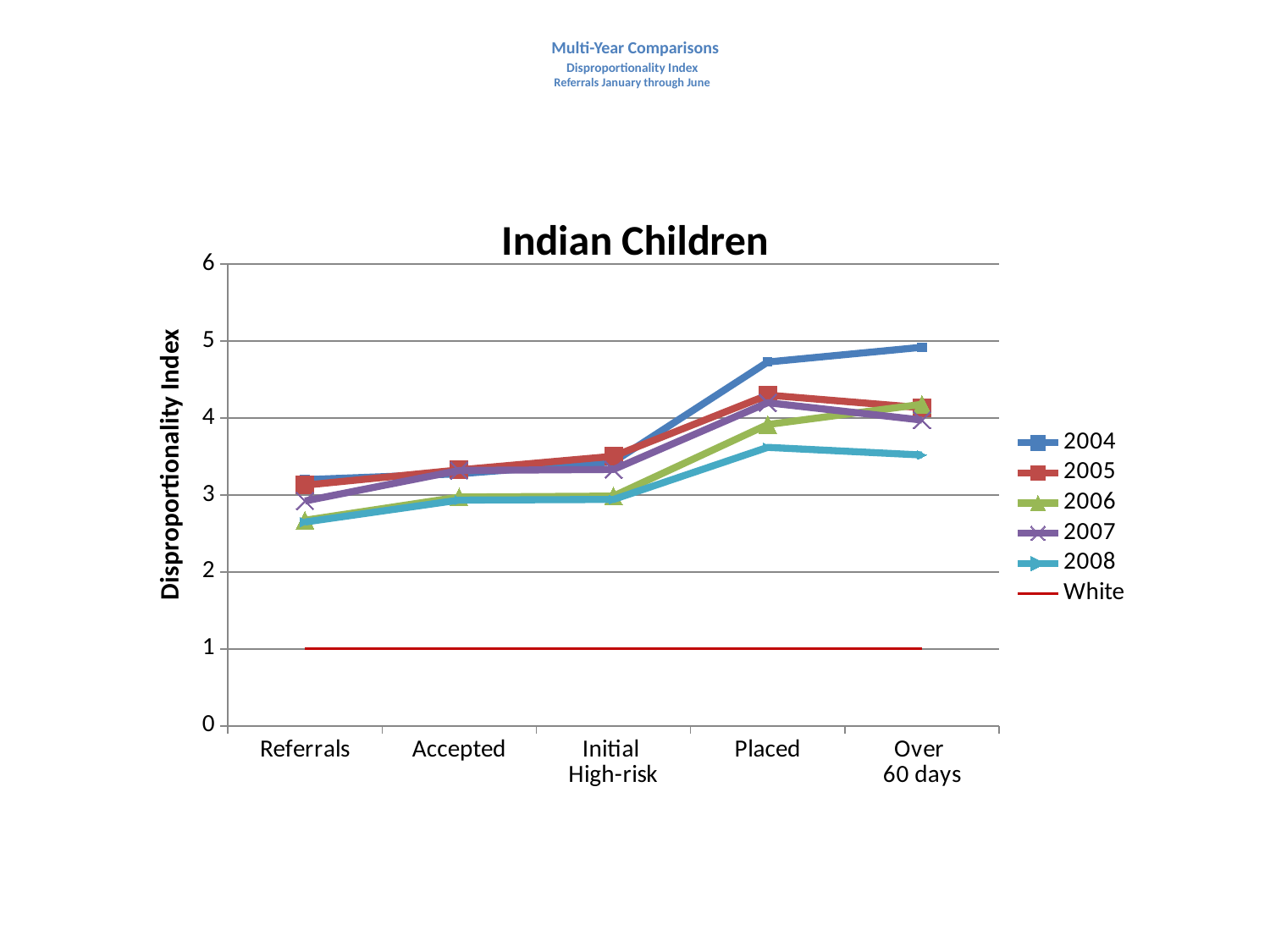
What is the label on the vertical axis? Disproportionality Index What is the title of the chart? Indian Children Which year series has the lowest value at Placed? 2008 Which series has the highest value at Over 60 days? 2004 Does the 2004 series generally rise or fall from Referrals to Over 60 days? rise How many categories are shown on the x axis? 5 At what value does the White line sit across all categories? 1 Is the value for 2004 at Placed greater or less than 4? greater Is the value for 2008 at Referrals greater or less than 3? less How many series does the legend list? 6 What kind of chart is shown on the slide? line chart